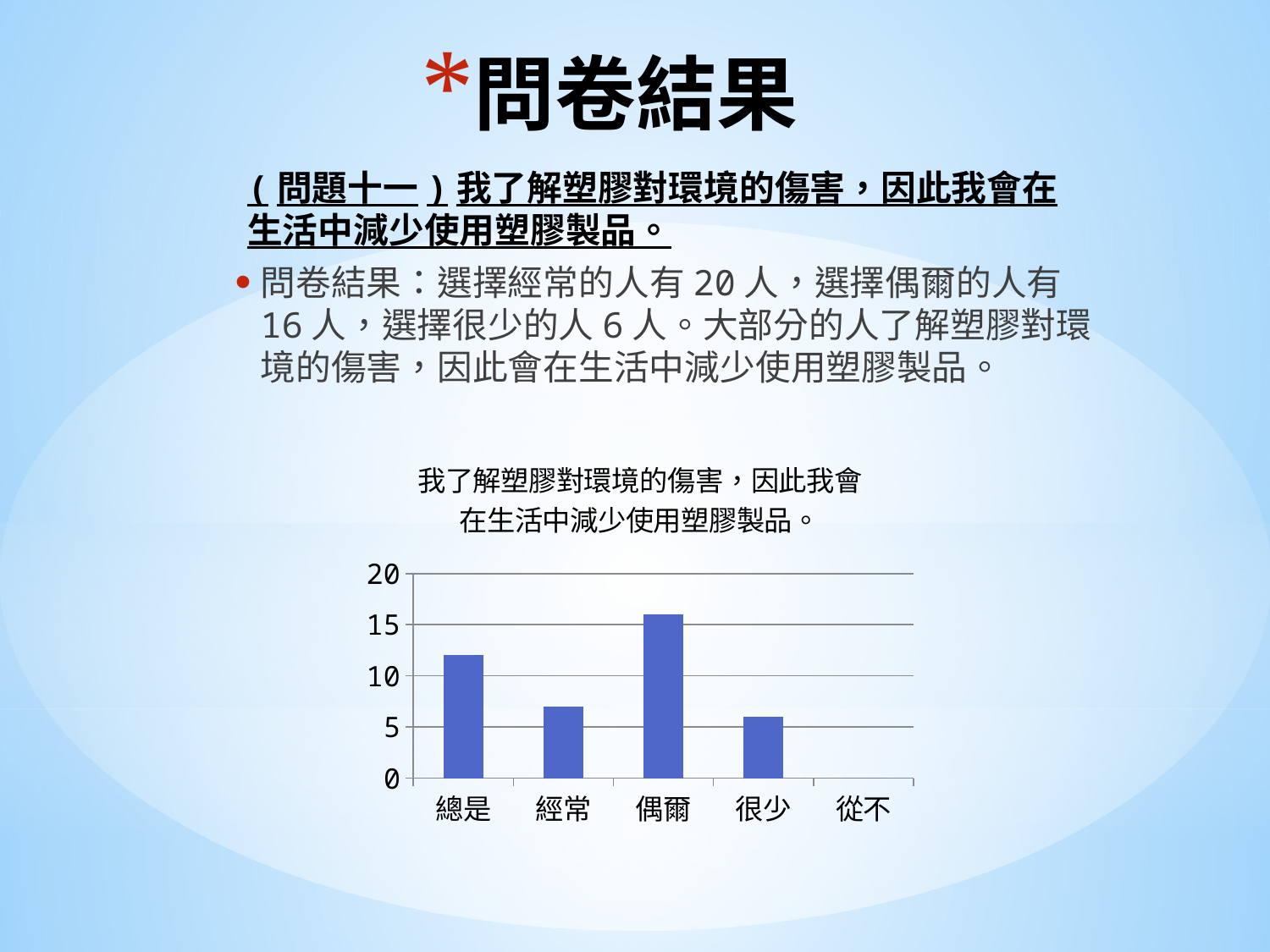
Is the value for 偶爾 greater or less than 10? greater What is the value for 從不 in the chart? 0 Which category has the lowest value in the chart? 從不 Is the value for 經常 greater or less than 10? less Is the value for 很少 greater or less than 10? less What kind of chart is shown on the slide? bar chart How many categories are shown on the x axis of the chart? 5 What is the title of the chart? 我了解塑膠對環境的傷害，因此我會在生活中減少使用塑膠製品。 Which category has the highest bar in the chart? 偶爾 Which is larger in the chart, the value for 總是 or the value for 經常? 總是 Which is larger in the chart, the value for 偶爾 or the value for 總是? 偶爾